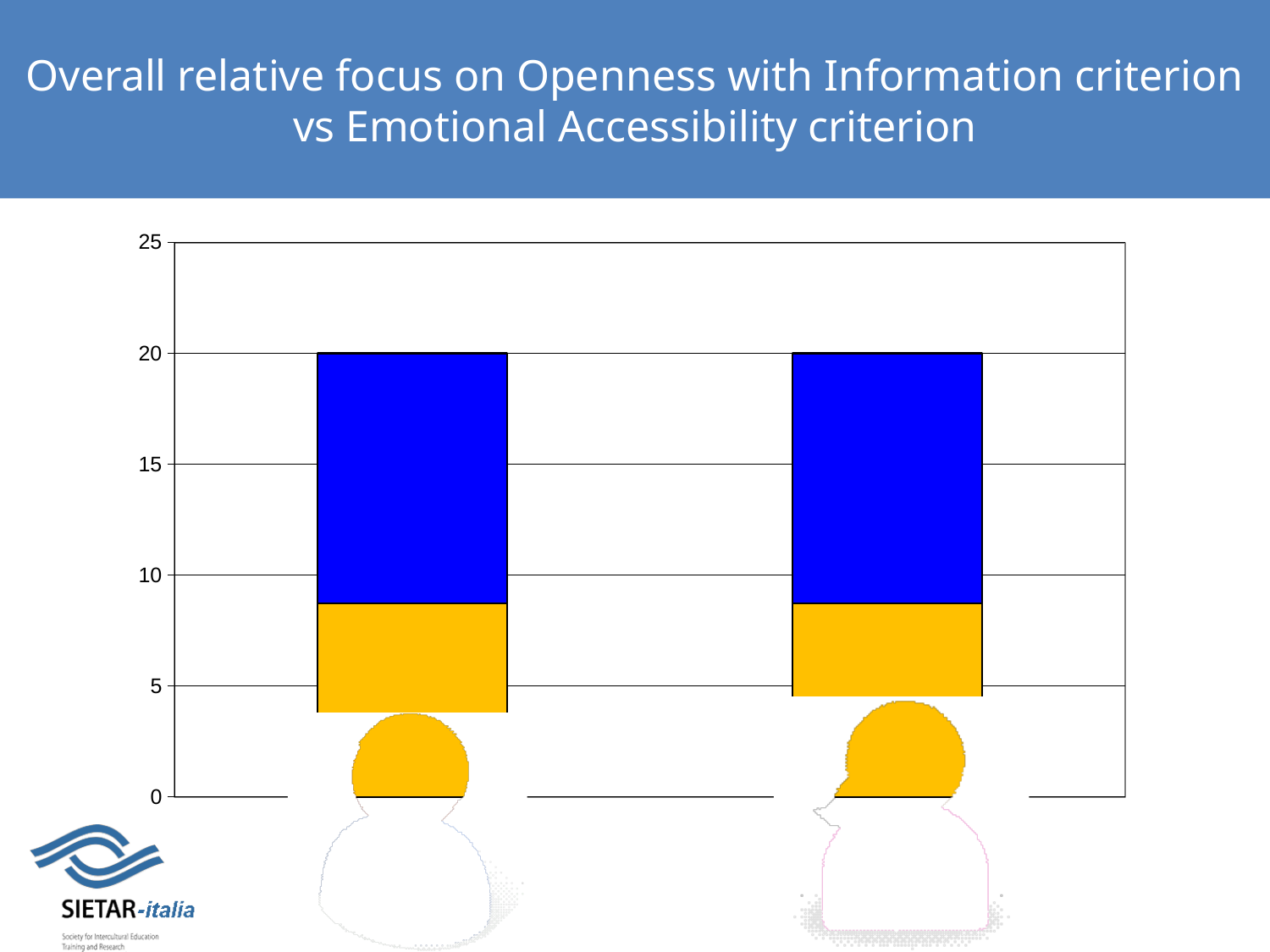
What value does the top of the right bar reach on the y axis? 20 Which segment is taller in the left bar, the blue one or the yellow one? the blue one What two colours are used for the bar segments? blue and yellow How many bars are plotted in the chart? 2 Is the bottom of the yellow segment of the left bar greater or less than 5? less What value does the top of the left bar reach on the y axis? 20 Is the top of the left bar greater or less than 15? greater Is the boundary between the yellow and blue segments of the left bar greater or less than 10? less What is the maximum value shown on the y axis? 25 What kind of chart is shown on the slide? bar chart